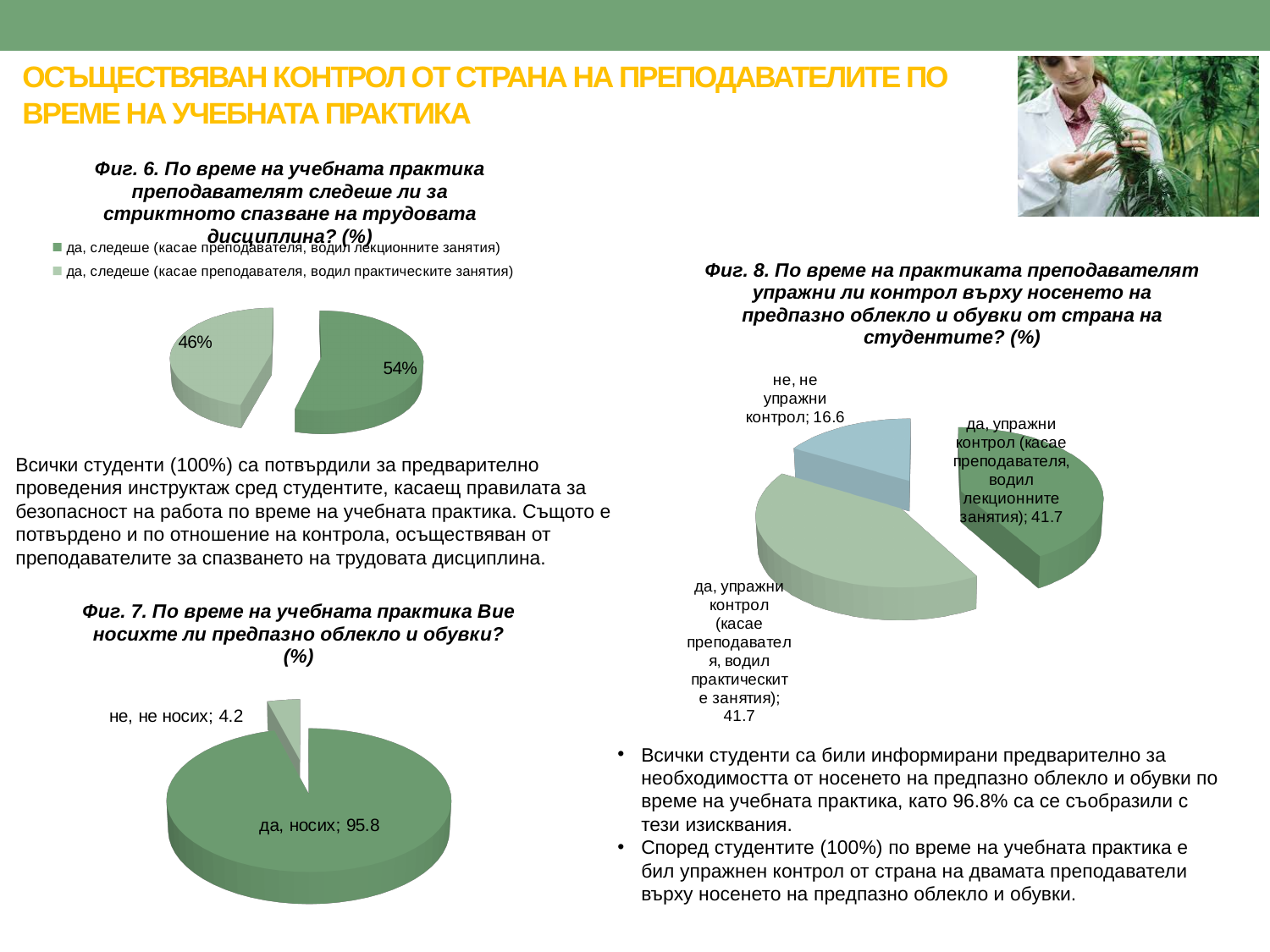
In the chart for Fig. 8, what value is shown for 'не, не упражни контрол'? 16.6 In the chart for Fig. 7, what value is shown for 'не, не носих'? 4.2 In the chart for Fig. 6, what percentage is shown for the slice 'да, следеше (касае преподавателя, водил практическите занятия)'? 46% In the chart for Fig. 7, which category has the smallest slice? не, не носих What type of chart is used for Fig. 7? Pie chart In the chart for Fig. 6, which slice is larger: the one for lecture classes (лекционните занятия) or the one for practical classes (практическите занятия)? лекционните занятия (54%) In the chart for Fig. 8, what is the combined value of the two 'да, упражни контрол' slices? 83.4 How many slices does the pie chart for Fig. 8 have? 3 How many entries does the legend of the Fig. 6 chart list? 2 In the chart for Fig. 6, what percentage is shown for the slice 'да, следеше (касае преподавателя, водил лекционните занятия)'? 54% In the chart for Fig. 6, what is the difference between the two slices? 8% In the chart for Fig. 7, what value is shown for 'да, носих'? 95.8